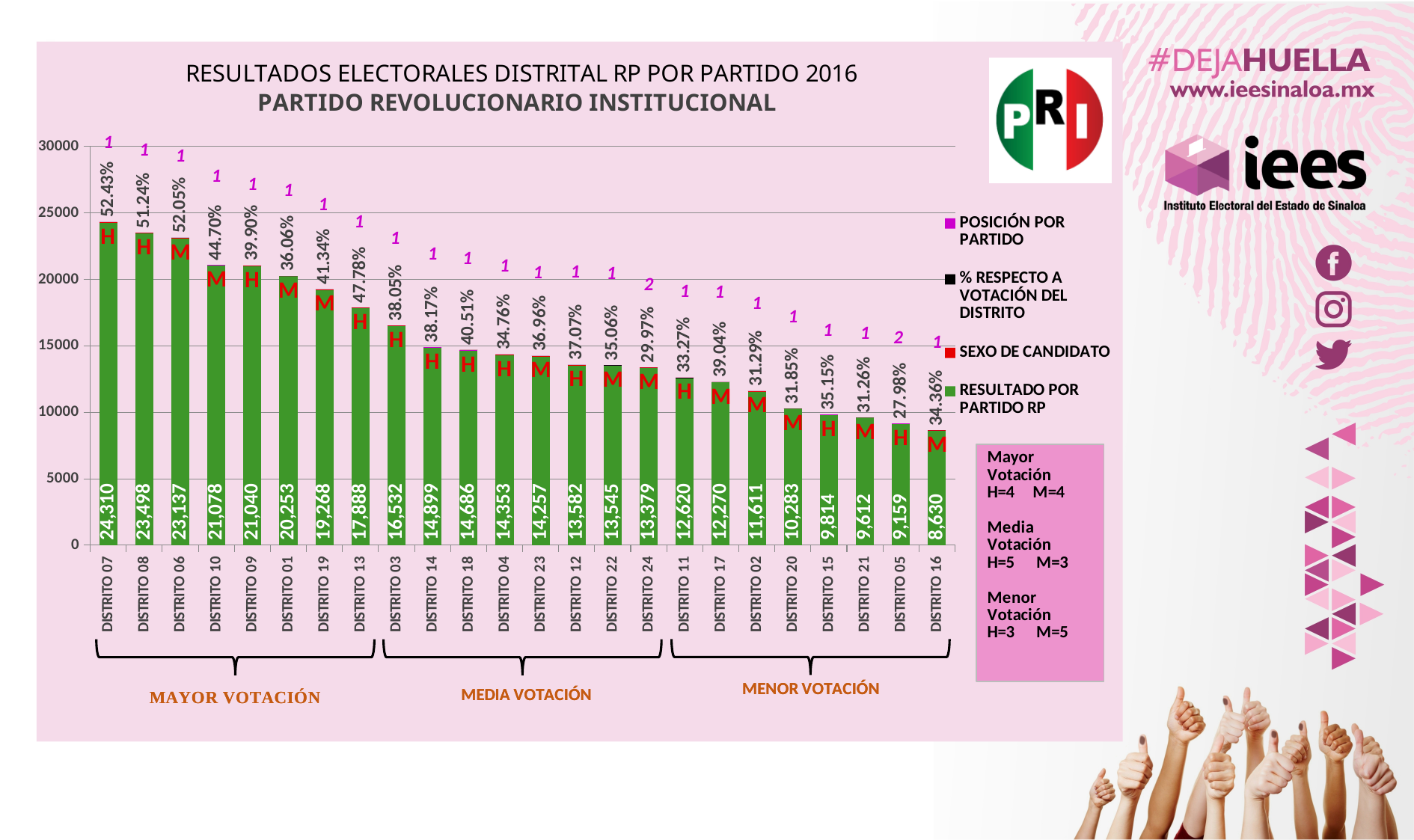
How many entries does the chart legend list? 4 What kind of chart is shown on the slide? Bar chart What percentage (% RESPECTO A VOTACIÓN DEL DISTRITO) is shown for DISTRITO 13? 47.78% What is the RESULTADO POR PARTIDO RP value for DISTRITO 07? 24,310 Which district has the highest RESULTADO POR PARTIDO RP? DISTRITO 07 What is the difference between the RESULTADO POR PARTIDO RP values of DISTRITO 07 and DISTRITO 08? 812 What is the RESULTADO POR PARTIDO RP value for DISTRITO 03? 16,532 How many districts are shown on the x axis of the chart? 24 What is the RESULTADO POR PARTIDO RP value for DISTRITO 16? 8,630 Which district has the lowest RESULTADO POR PARTIDO RP? DISTRITO 16 Which has a larger RESULTADO POR PARTIDO RP, DISTRITO 11 or DISTRITO 20? DISTRITO 11 Do the RESULTADO POR PARTIDO RP values rise or fall from left to right along the x axis? Fall